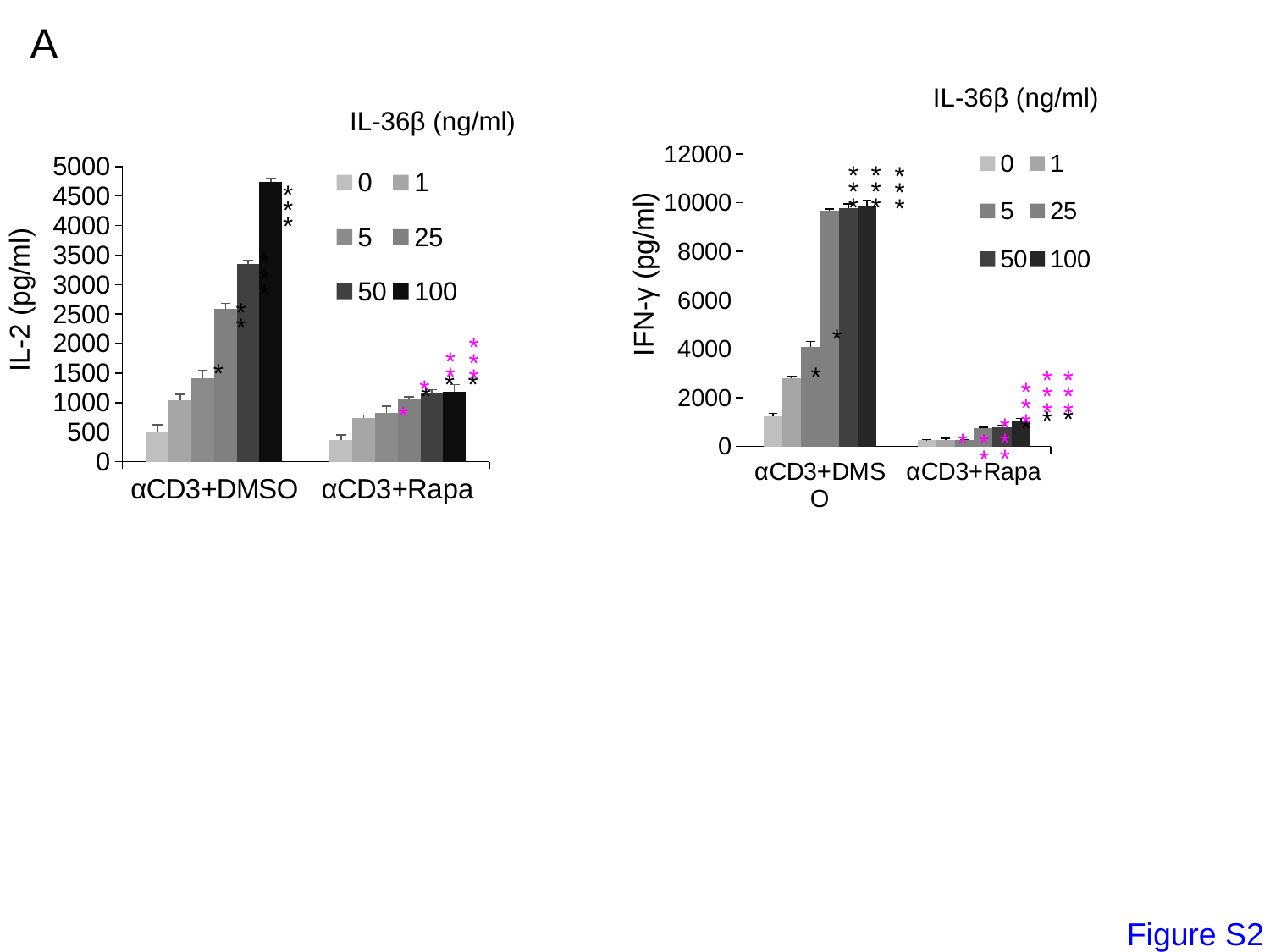
In the left chart (IL-2), do the αCD3+DMSO bars rise or fall as the IL-36β concentration increases from 0 to 100? rise What kind of chart is the left chart (IL-2)? bar chart In the left chart (IL-2), is the value for 0 ng/ml IL-36β in the αCD3+DMSO group greater or less than 1000? less In the right chart (IFN-γ), how many categories are shown on the x axis? 2 In the left chart (IL-2), how many series does the legend list? 6 In the right chart (IFN-γ), is the value for 100 ng/ml IL-36β in the αCD3+DMSO group greater or less than 8000? greater What is the y-axis label of the right chart? IFN-γ (pg/ml) In the left chart (IL-2), which is larger: the 100 ng/ml bar in αCD3+DMSO or the 100 ng/ml bar in αCD3+Rapa? αCD3+DMSO In the right chart (IFN-γ), is the value for 5 ng/ml IL-36β in the αCD3+DMSO group greater or less than 6000? less In the left chart (IL-2), which IL-36β concentration gives the highest bar in the αCD3+DMSO group? 100 In the right chart (IFN-γ), which is larger: the 25 ng/ml bar in αCD3+DMSO or the 25 ng/ml bar in αCD3+Rapa? αCD3+DMSO